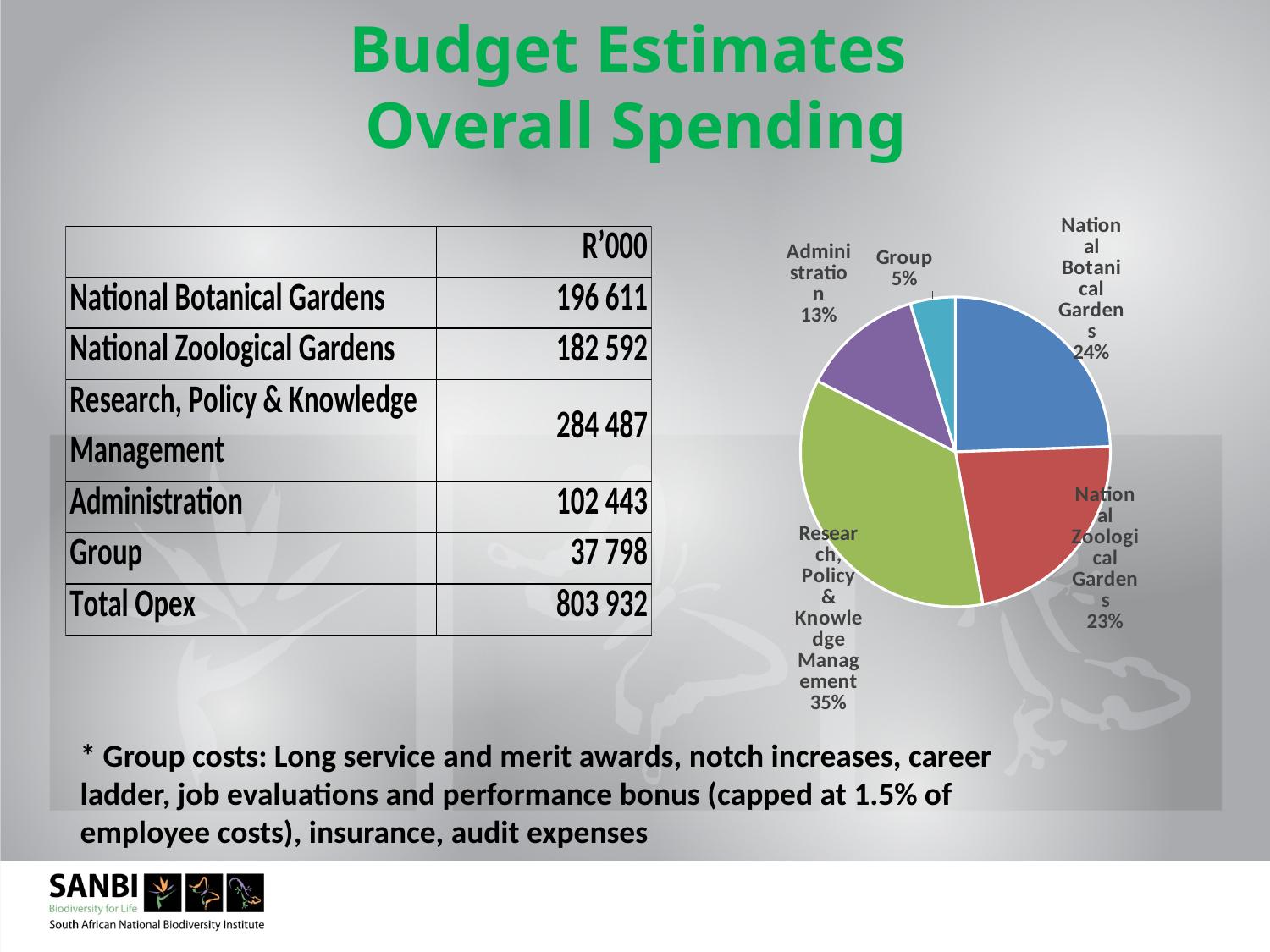
What share of the pie does National Zoological Gardens represent? 23% Which is larger in the pie chart, Administration or Group? Administration What share of the pie does Research, Policy & Knowledge Management represent? 35% What is the difference in percentage points between the Research, Policy & Knowledge Management slice and the Administration slice? 22 What share of the pie does National Botanical Gardens represent? 24% What kind of chart is shown on the slide? pie chart Which slice of the pie chart is the largest? Research, Policy & Knowledge Management How many slices does the pie chart have? 5 Which slice of the pie chart is the smallest? Group What colour is the Research, Policy & Knowledge Management slice in the pie chart? green